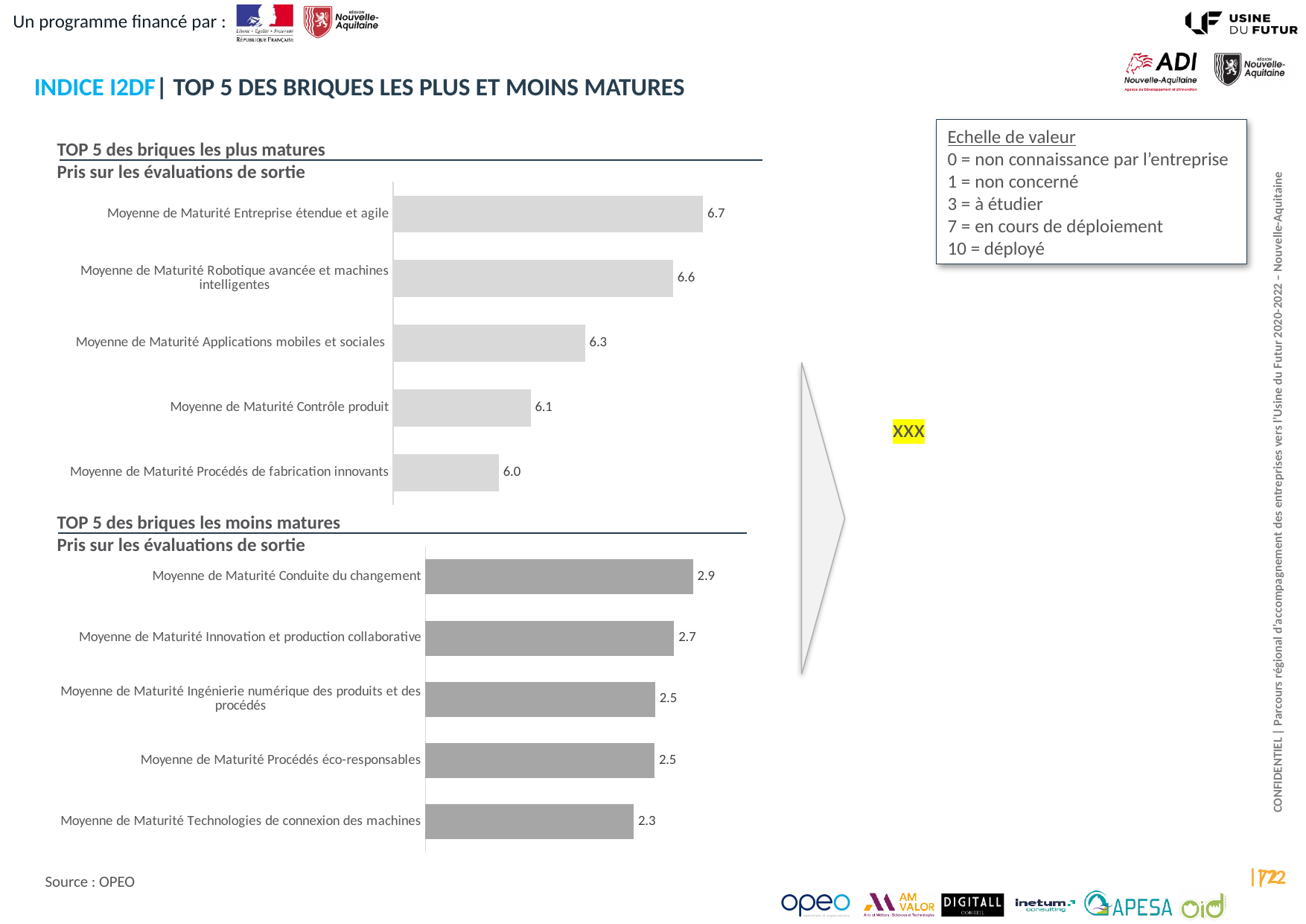
In the 'TOP 5 des briques les moins matures' chart, which category has the highest value? Moyenne de Maturité Conduite du changement In the 'TOP 5 des briques les moins matures' chart, what is the value for 'Moyenne de Maturité Technologies de connexion des machines'? 2.3 In the 'TOP 5 des briques les moins matures' chart, what is the value for 'Moyenne de Maturité Conduite du changement'? 2.9 In the 'TOP 5 des briques les plus matures' chart, what is the value for 'Moyenne de Maturité Contrôle produit'? 6.1 In the 'TOP 5 des briques les plus matures' chart, how many categories are plotted? 5 What kind of chart is the 'TOP 5 des briques les moins matures' chart? Bar chart In the 'TOP 5 des briques les plus matures' chart, what is the difference between 'Moyenne de Maturité Entreprise étendue et agile' and 'Moyenne de Maturité Procédés de fabrication innovants'? 0.7 What is the source cited for the charts on the slide? OPEO In the 'TOP 5 des briques les moins matures' chart, which is larger: 'Moyenne de Maturité Innovation et production collaborative' or 'Moyenne de Maturité Technologies de connexion des machines'? Moyenne de Maturité Innovation et production collaborative In the 'TOP 5 des briques les plus matures' chart, what is the value for 'Moyenne de Maturité Entreprise étendue et agile'? 6.7 In the 'TOP 5 des briques les plus matures' chart, which category has the lowest value? Moyenne de Maturité Procédés de fabrication innovants In the 'TOP 5 des briques les moins matures' chart, what is the difference between 'Moyenne de Maturité Conduite du changement' and 'Moyenne de Maturité Innovation et production collaborative'? 0.2